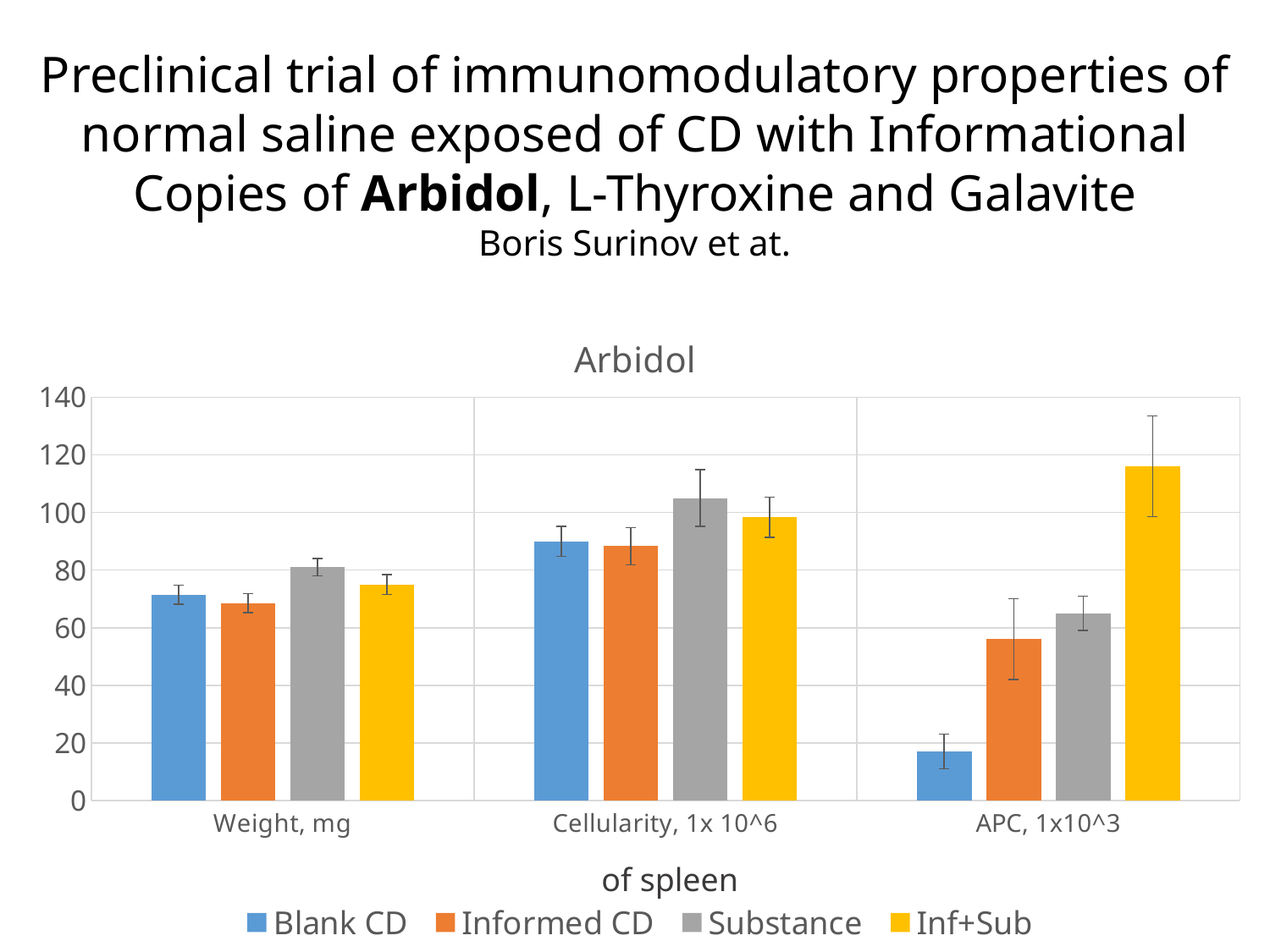
How many series does the legend list? 4 Which series has the highest value for APC, 1x10^3? Inf+Sub Which series has the highest value for Weight, mg? Substance Is the Inf+Sub value for APC, 1x10^3 greater or less than 100? greater What is the title of the chart? Arbidol For Weight, mg, which is larger: Substance or Blank CD? Substance How many categories are shown on the x axis? 3 What is the x-axis title of the chart? of spleen Is the Blank CD value for APC, 1x10^3 greater or less than 40? less Which series has the lowest value for APC, 1x10^3? Blank CD What kind of chart is shown on the slide? bar chart Is the Substance value for Cellularity, 1x 10^6 greater or less than 100? greater